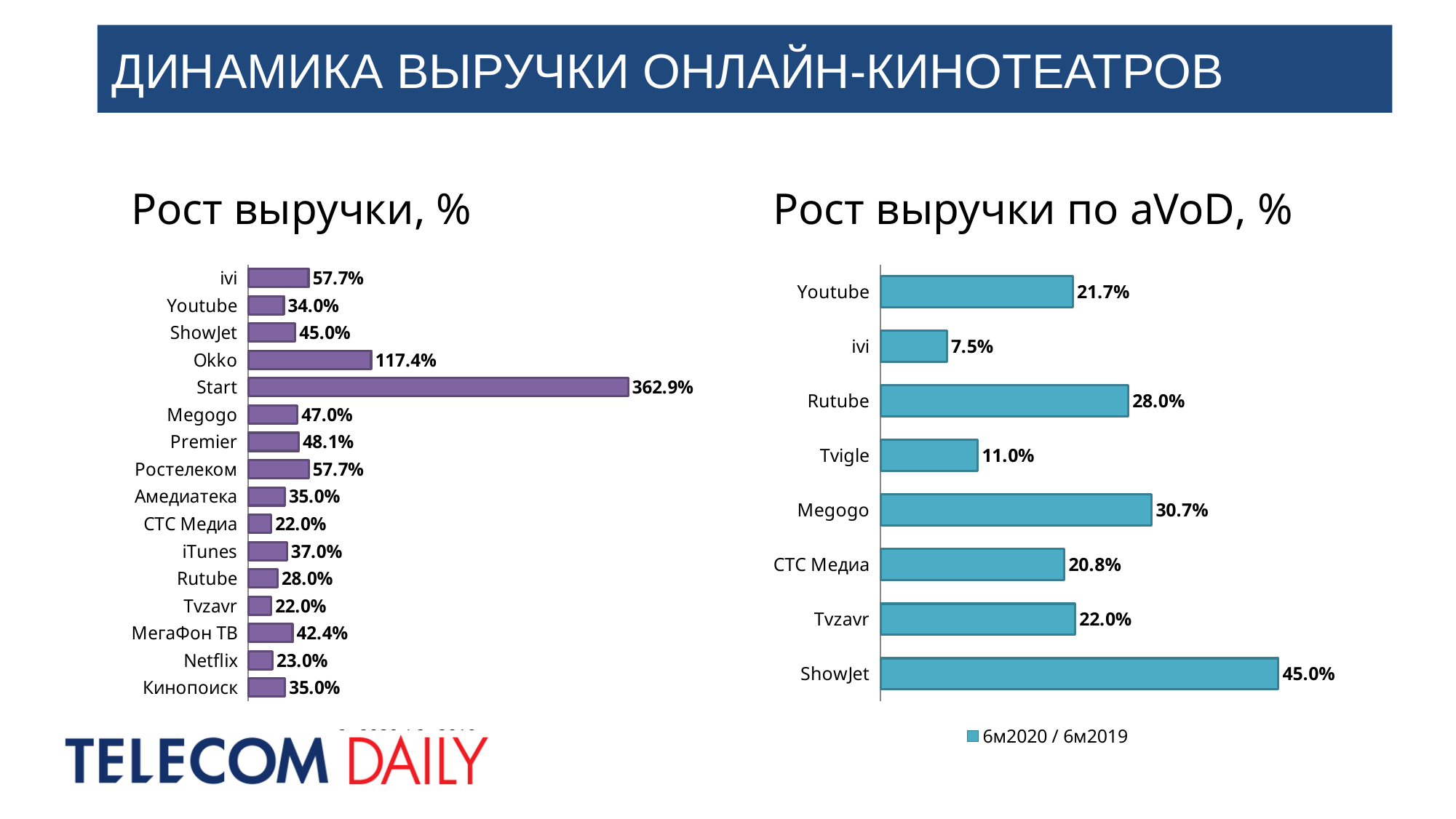
In the chart 'Рост выручки, %', what is the value for Okko? 117.4% In the chart 'Рост выручки, %', what is the difference between the values for Okko and Youtube? 83.4% How many categories are shown in the chart 'Рост выручки, %'? 16 In the chart 'Рост выручки по aVoD, %', which category has the lowest value? ivi In the chart 'Рост выручки, %', which category has the highest value? Start In the chart 'Рост выручки по aVoD, %', what is the difference between the values for ShowJet and Rutube? 17.0% In the chart 'Рост выручки по aVoD, %', which category has the highest value? ShowJet In the chart 'Рост выручки, %', which is larger, the value for Premier or the value for Megogo? Premier How many categories are shown in the chart 'Рост выручки по aVoD, %'? 8 In the chart 'Рост выручки по aVoD, %', what is the value for Megogo? 30.7% What kind of chart is 'Рост выручки по aVoD, %'? Bar chart In the chart 'Рост выручки, %', what is the value for Start? 362.9%